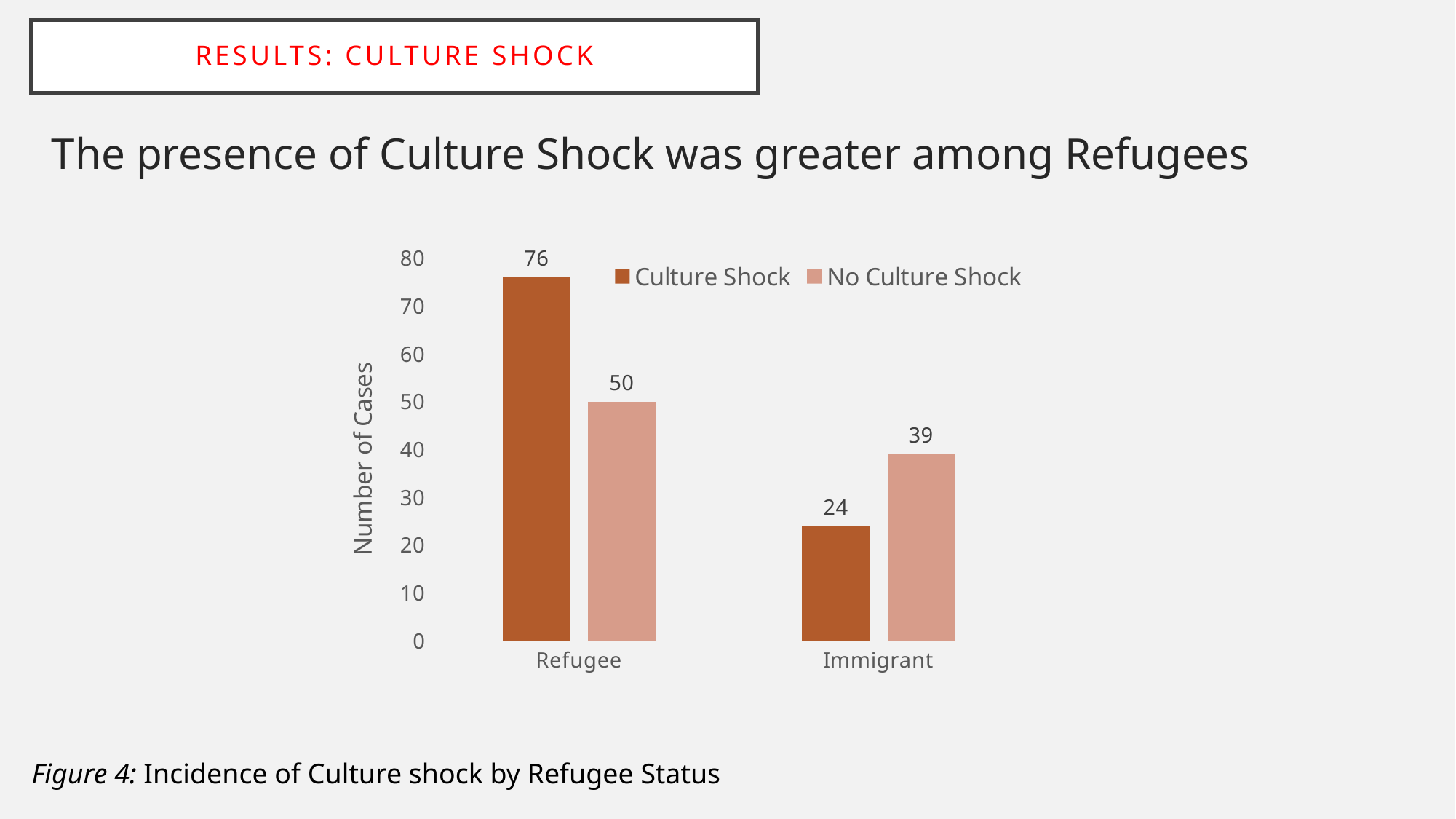
For Immigrant, which is larger: Culture Shock or No Culture Shock? No Culture Shock What is the number of Culture Shock cases for Refugee? 76 How many series does the legend list? 2 What is the difference between the Culture Shock values for Refugee and Immigrant? 52 What is the number of No Culture Shock cases for Immigrant? 39 What is the number of No Culture Shock cases for Refugee? 50 Which category has the lowest No Culture Shock value? Immigrant How many categories are shown on the x axis? 2 What is the number of Culture Shock cases for Immigrant? 24 What is the label of the y axis? Number of Cases Which category has the highest Culture Shock value? Refugee What kind of chart is shown on the slide? Bar chart